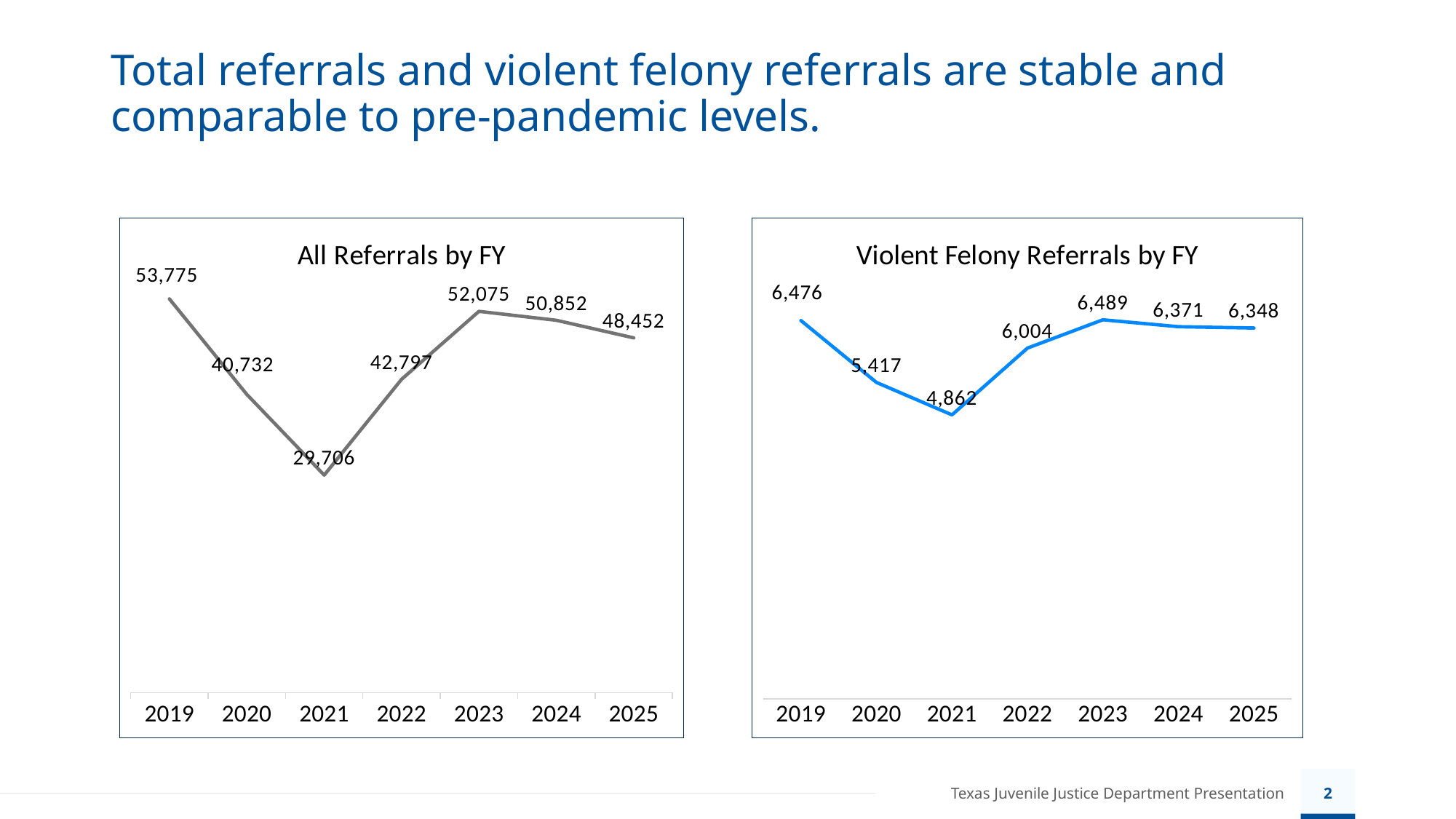
In the 'All Referrals by FY' chart, do the values rise or fall from 2023 to 2025? Fall In the 'Violent Felony Referrals by FY' chart, what is the difference between the 2023 value and the 2022 value? 485 In the 'Violent Felony Referrals by FY' chart, what is the value for 2025? 6,348 In the 'All Referrals by FY' chart, what is the difference between the 2019 value and the 2021 value? 24,069 In the 'Violent Felony Referrals by FY' chart, which year has the lowest value? 2021 In the 'Violent Felony Referrals by FY' chart, which is larger, the value for 2019 or the value for 2023? 2023 How many years are plotted in the 'All Referrals by FY' chart? 7 What kind of chart is 'Violent Felony Referrals by FY'? Line chart In the 'All Referrals by FY' chart, which year has the highest value? 2019 What colour is the line in the 'Violent Felony Referrals by FY' chart? Blue In the 'All Referrals by FY' chart, what is the value for 2021? 29,706 In the 'All Referrals by FY' chart, which is larger, the value for 2020 or the value for 2022? 2022